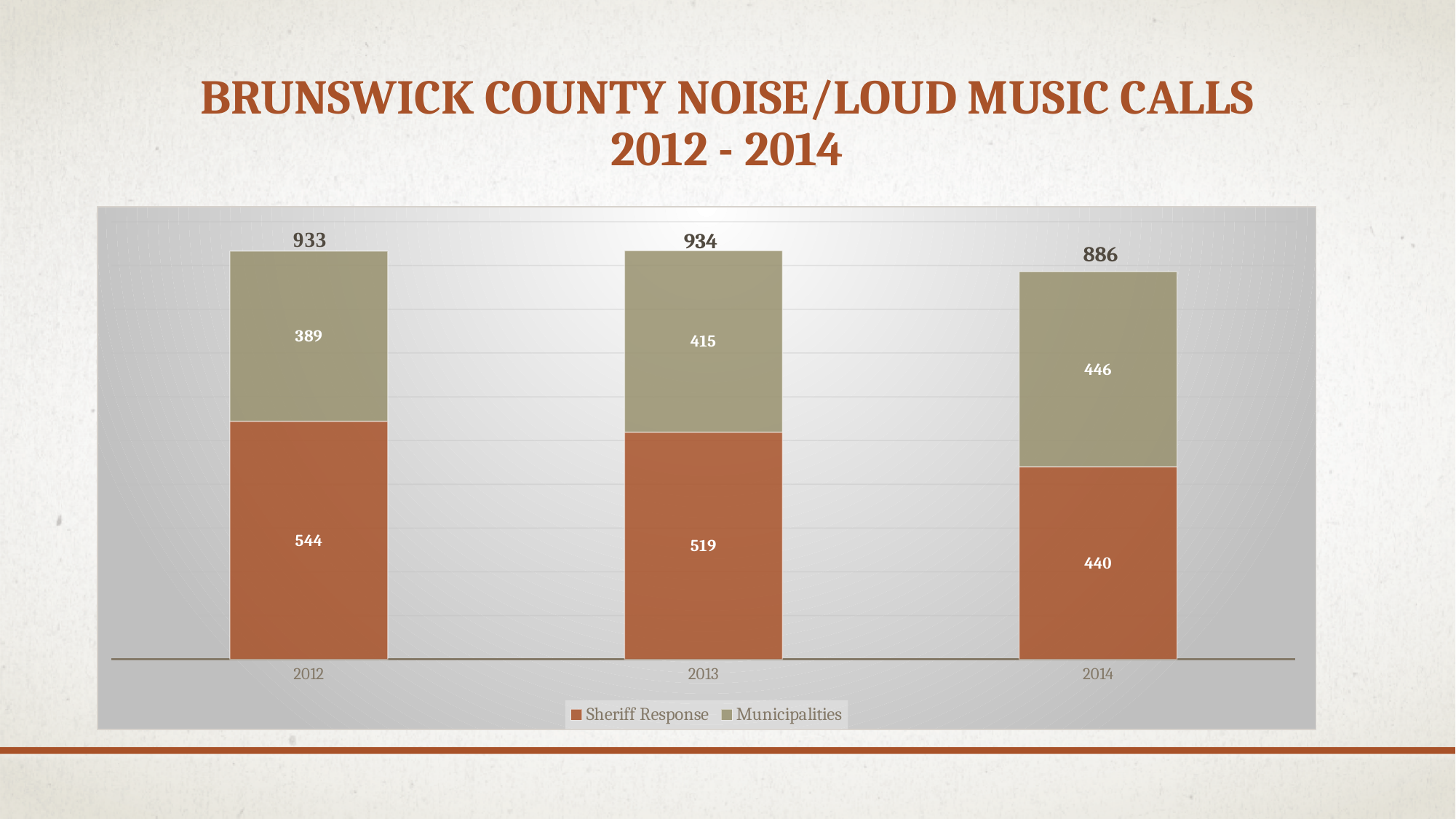
Which year has the lowest total number of calls? 2014 What is the Sheriff Response value for 2012? 544 Which year has the highest Sheriff Response value? 2012 What is the total of the stacked bar for 2013? 934 What is the Municipalities value for 2013? 415 How many series does the legend list? 2 What is the Municipalities value for 2014? 446 How many years are shown on the x axis? 3 Do the Municipalities values rise or fall from 2012 to 2014? rise What is the total of the stacked bar for 2014? 886 What is the difference between the Sheriff Response values for 2012 and 2014? 104 Is the Municipalities value larger in 2012 or in 2014? 2014